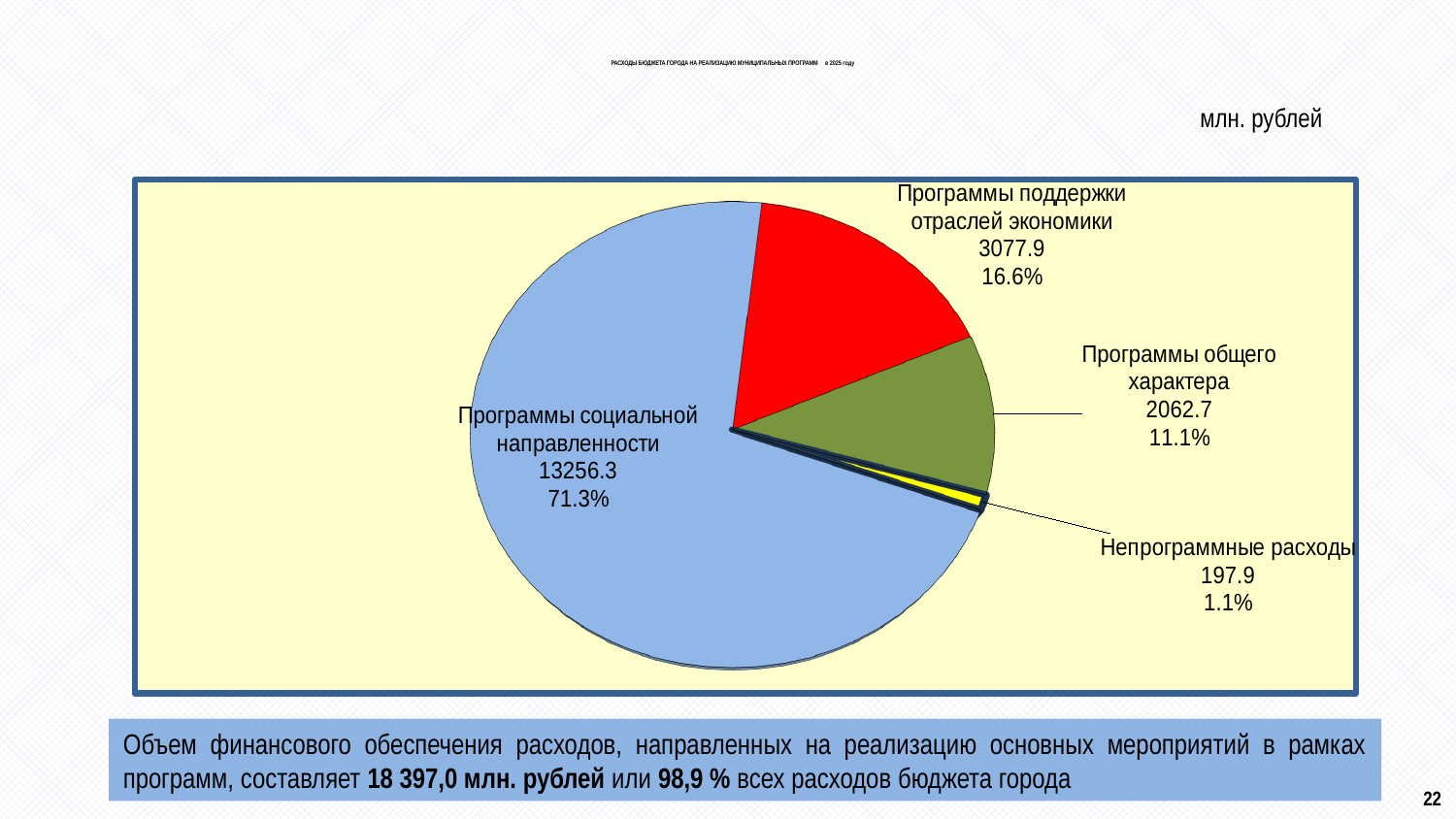
What is the value for Программы общего характера? 2062.7 Which slice is the largest? Программы социальной направленности What is the value for Программы социальной направленности? 13256.3 What share of the pie does Программы поддержки отраслей экономики represent? 16.6% What is the difference between the values for Программы поддержки отраслей экономики and Программы общего характера? 1015.2 How many slices does the pie chart have? 4 Which slice is the smallest? Непрограммные расходы What kind of chart is shown on the slide? Pie chart What share of the pie does Непрограммные расходы represent? 1.1% What unit is indicated for the values in the chart? млн. рублей What is the value for Программы поддержки отраслей экономики? 3077.9 What is the value for Непрограммные расходы? 197.9